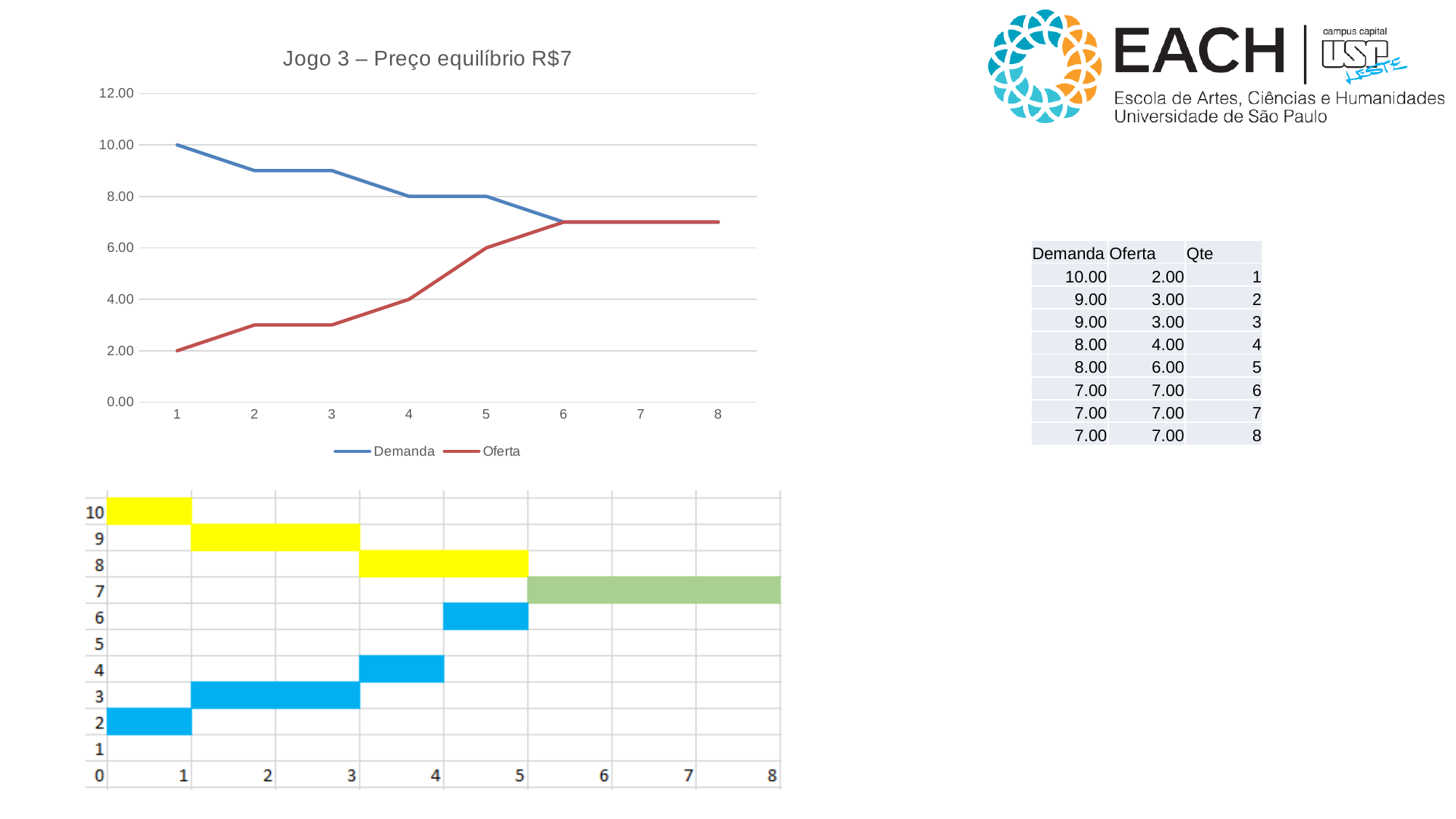
In the "Jogo 3 – Preço equilíbrio R$7" chart, what is the value of Demanda at x = 4? 8.00 In the "Jogo 3 – Preço equilíbrio R$7" chart, what is the difference between Demanda and Oferta at x = 1? 8.00 In the "Jogo 3 – Preço equilíbrio R$7" chart, does the Demanda series rise or fall from x = 1 to x = 6? fall In the "Jogo 3 – Preço equilíbrio R$7" chart, what is the value of Demanda at x = 1? 10.00 What type of chart is "Jogo 3 – Preço equilíbrio R$7"? line chart In the "Jogo 3 – Preço equilíbrio R$7" chart, what is the value of Oferta at x = 1? 2.00 In the "Jogo 3 – Preço equilíbrio R$7" chart, which series is higher at x = 2, Demanda or Oferta? Demanda How many series does the legend of the "Jogo 3 – Preço equilíbrio R$7" chart list? 2 How many points are plotted along the x axis for each series in the "Jogo 3 – Preço equilíbrio R$7" chart? 8 In the "Jogo 3 – Preço equilíbrio R$7" chart, does the Oferta series rise or fall from x = 1 to x = 6? rise In the "Jogo 3 – Preço equilíbrio R$7" chart, what colour is the Oferta line? red In the "Jogo 3 – Preço equilíbrio R$7" chart, what is the value of Oferta at x = 5? 6.00